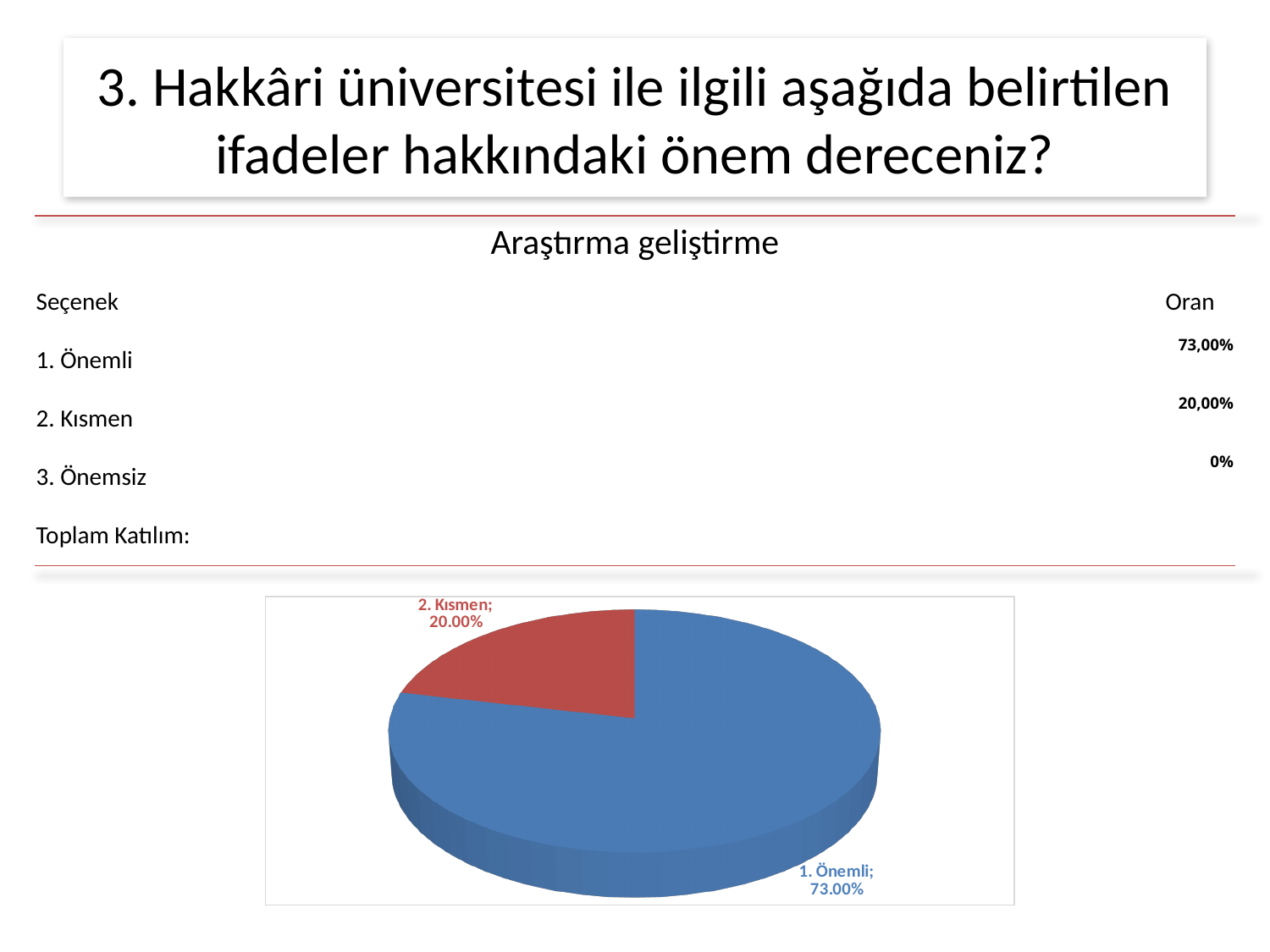
What colour is the "2. Kısmen" slice in the pie chart? red What kind of chart is shown on the slide? pie chart According to the table above the chart, what is the value for "3. Önemsiz"? 0% What colour is the "1. Önemli" slice in the pie chart? blue Which labelled slice of the pie chart is the smallest? 2. Kısmen Which slice of the pie chart is the largest? 1. Önemli What is the value shown for the "1. Önemli" slice in the pie chart? 73.00% How many labelled slices does the pie chart show? 2 What is the value shown for the "2. Kısmen" slice in the pie chart? 20.00% What is the difference between the "1. Önemli" and "2. Kısmen" slices in the pie chart? 53.00% Which is larger in the pie chart, "1. Önemli" or "2. Kısmen"? 1. Önemli Is the value for "1. Önemli" in the pie chart greater or less than 50%? greater